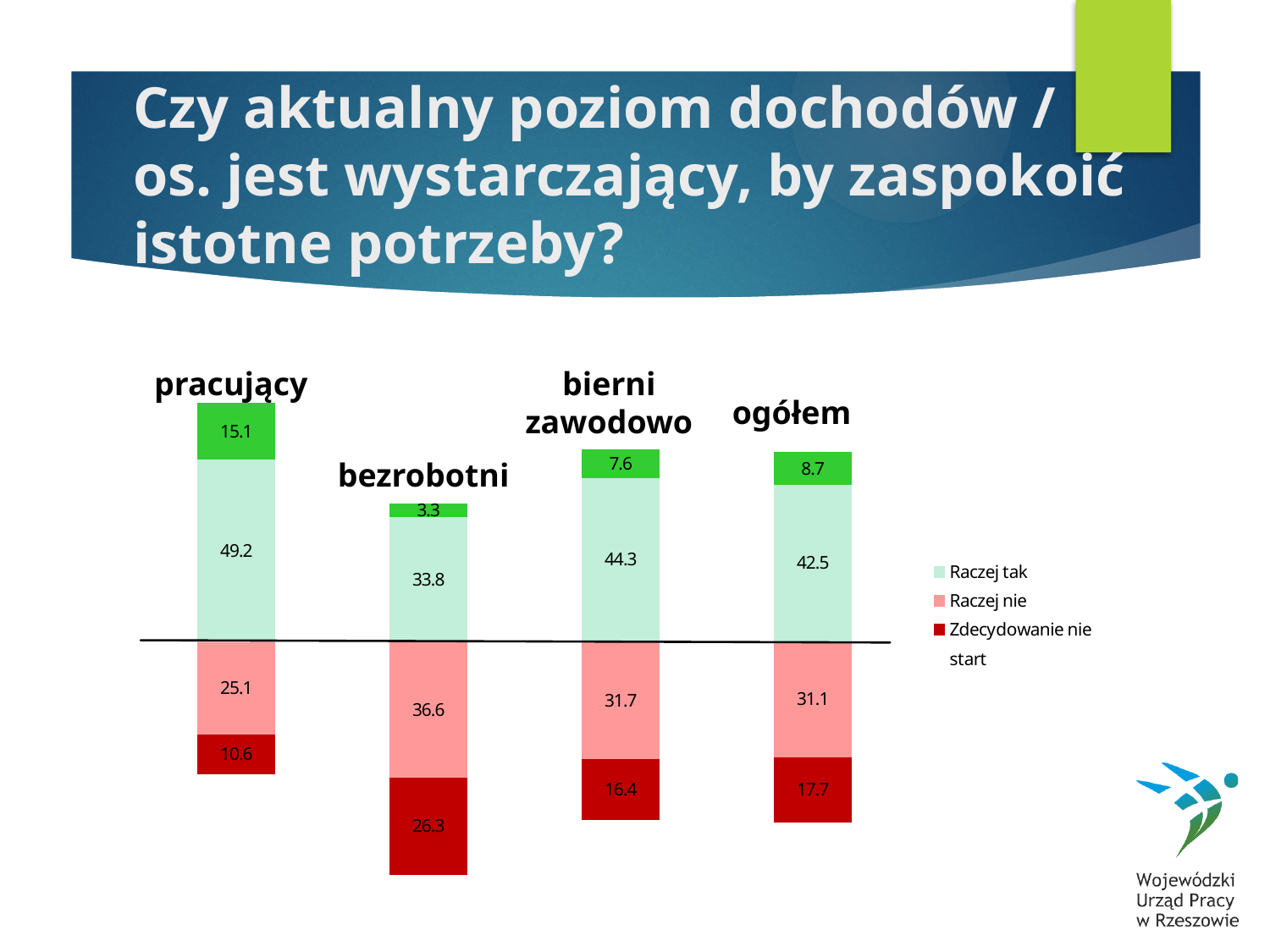
What is the value of the Raczej nie segment for bierni zawodowo? 31.7 What is the value of the Raczej tak segment for pracujący? 49.2 How many categories are shown in the chart? 4 Which has a larger Raczej tak value, bierni zawodowo or ogółem? bierni zawodowo Which category has the lowest Zdecydowanie nie value? pracujący How many entries does the legend list? 4 What is the difference between the Raczej nie values for bezrobotni and pracujący? 11.5 What is the total of all segments in the ogółem bar? 100 What is the value of the green top segment for ogółem? 8.7 What is the value of the Zdecydowanie nie segment for bezrobotni? 26.3 Which category has the highest Raczej tak value? pracujący What kind of chart is shown on the slide? stacked bar chart